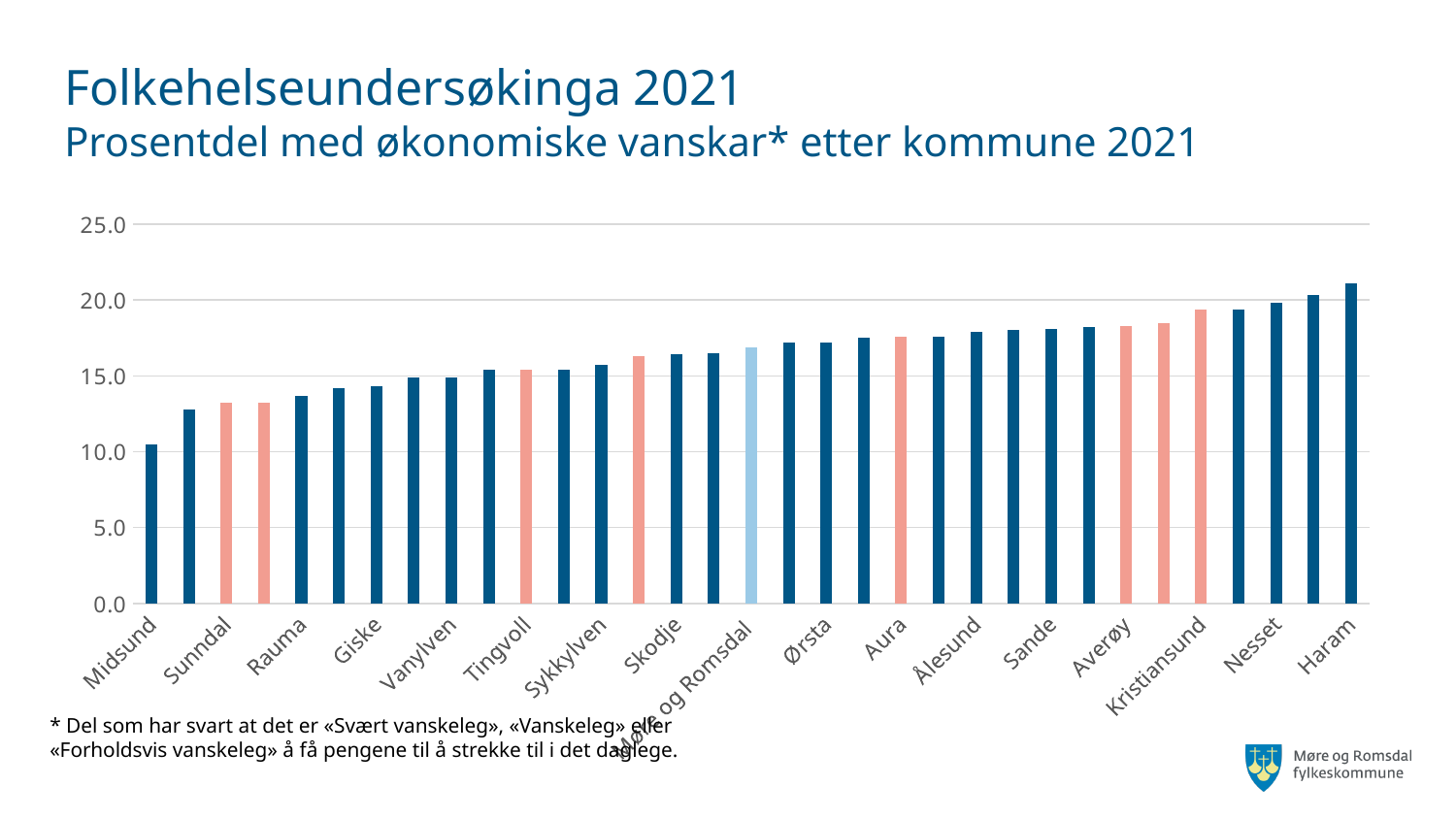
Is the value for Ørsta greater or less than 15.0? greater Is the value for Sunndal greater or less than 10.0? greater Is the value for Giske greater or less than 15.0? less What is the subtitle of the chart on the slide? Prosentdel med økonomiske vanskar* etter kommune 2021 Which kommune has the lowest share with economic difficulties? Midsund Which has a larger value, Haram or Midsund? Haram Do the values rise or fall from left to right along the x axis? Rise What kind of chart is shown on the slide? Bar chart Which kommune has the highest share with economic difficulties? Haram